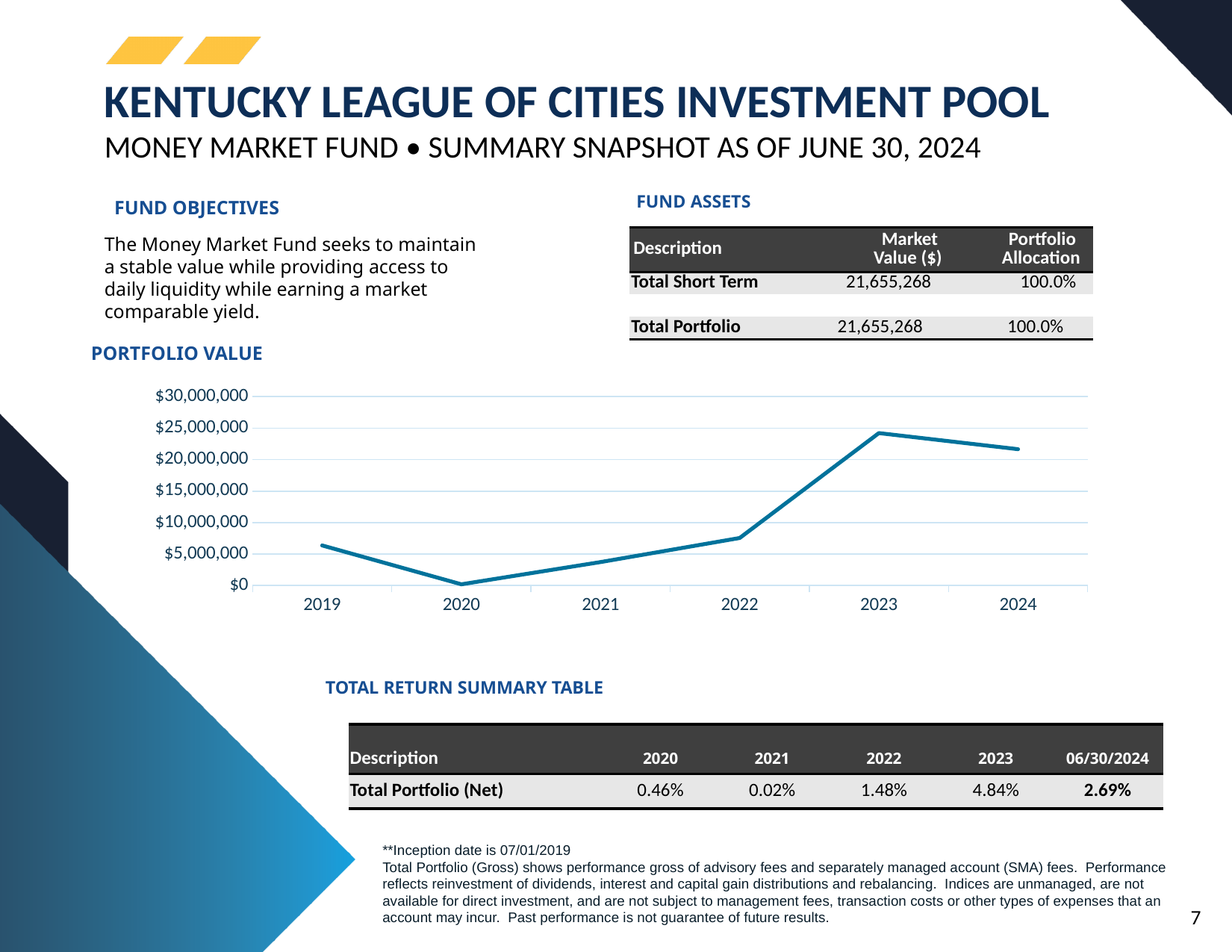
Which year has the larger portfolio value, 2019 or 2021? 2019 What is the highest value labelled on the y axis of the Portfolio Value chart? $30,000,000 Is the portfolio value for 2023 greater or less than $20,000,000? greater What kind of chart is the Portfolio Value chart? line chart In which year does the Portfolio Value chart reach its highest value? 2023 Is the portfolio value for 2022 greater or less than $10,000,000? less Does the portfolio value rise or fall from 2022 to 2023? rise In which year does the Portfolio Value chart show its lowest value? 2020 Is the portfolio value for 2024 greater or less than $15,000,000? greater Which year has the larger portfolio value, 2023 or 2024? 2023 How many years are shown on the x axis of the Portfolio Value chart? 6